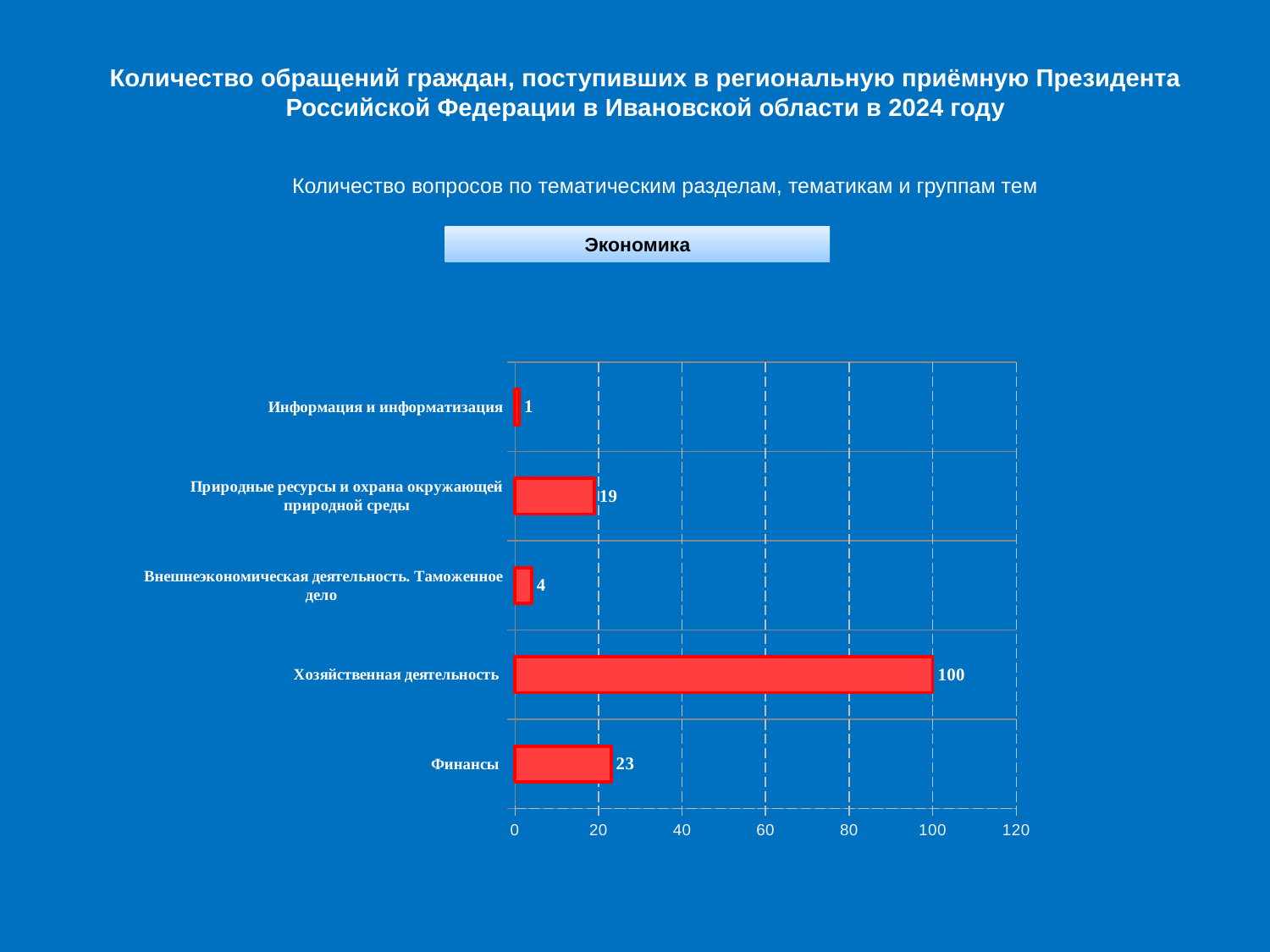
What is the value for Природные ресурсы и охрана окружающей природной среды? 19 Which category has the lowest value? Информация и информатизация What kind of chart is shown on the slide? bar chart How many categories are shown in the chart? 5 What is the value for Хозяйственная деятельность? 100 Which category has the highest value? Хозяйственная деятельность What is the value for Информация и информатизация? 1 Which is larger, the value for Финансы or the value for Природные ресурсы и охрана окружающей природной среды? Финансы What is the heading shown in the box above the chart? Экономика What is the difference between the values for Хозяйственная деятельность and Финансы? 77 What is the value for Финансы? 23 What is the value for Внешнеэкономическая деятельность. Таможенное дело? 4